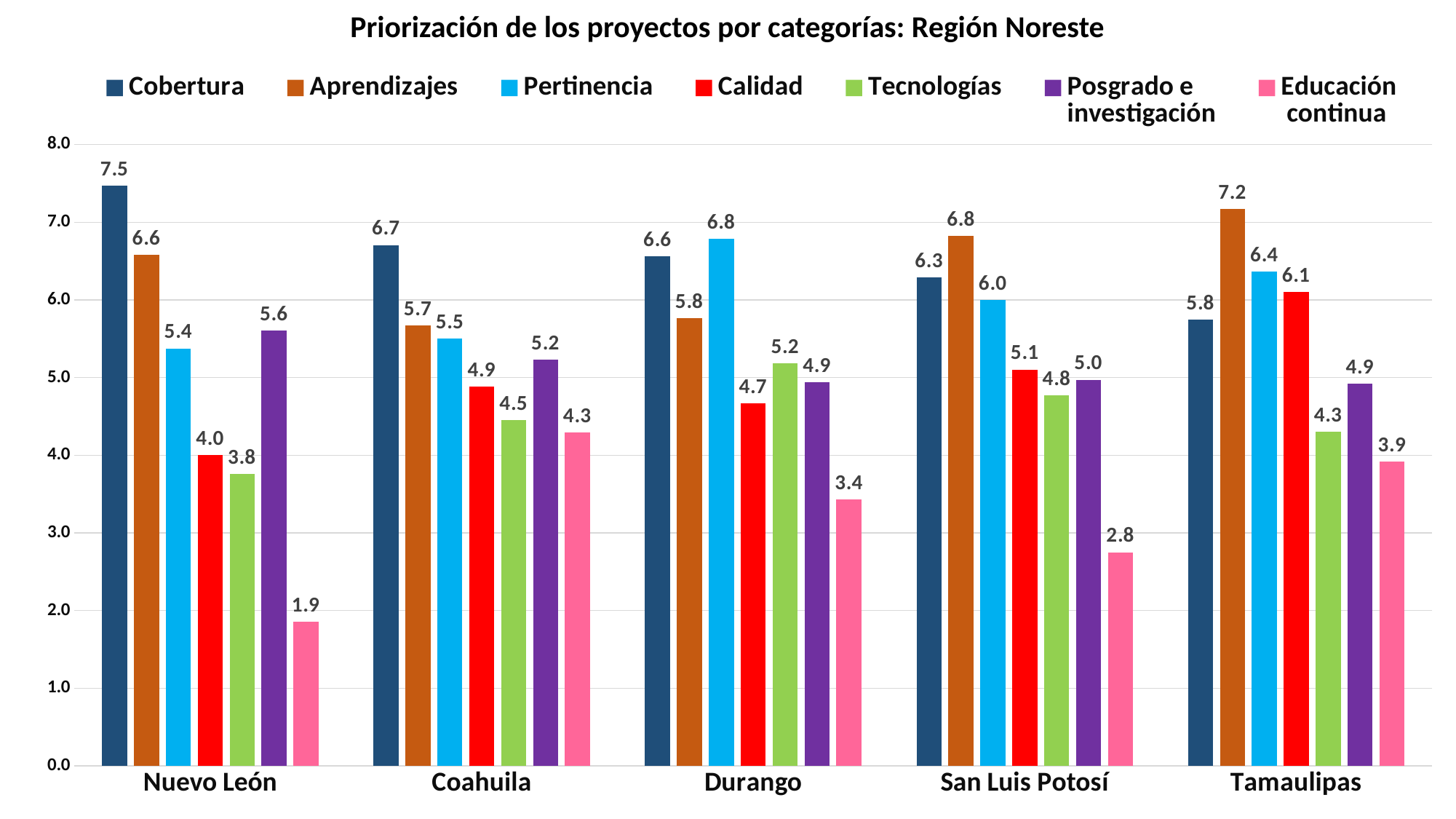
What kind of chart is shown? Bar chart What is the title of the chart? Priorización de los proyectos por categorías: Región Noreste How many series does the legend list? 7 Which is larger in Coahuila: Cobertura or Aprendizajes? Cobertura What is the value for Cobertura in Nuevo León? 7.5 Which category has the lowest value for Nuevo León? Educación continua Is the value for Tecnologías in Durango greater or less than 5.0? greater How many states are shown on the x axis? 5 What is the difference between Cobertura and Calidad in Nuevo León? 3.5 What is the value for Aprendizajes in Tamaulipas? 7.2 What is the value for Educación continua in San Luis Potosí? 2.8 Which category has the highest value for Durango? Pertinencia